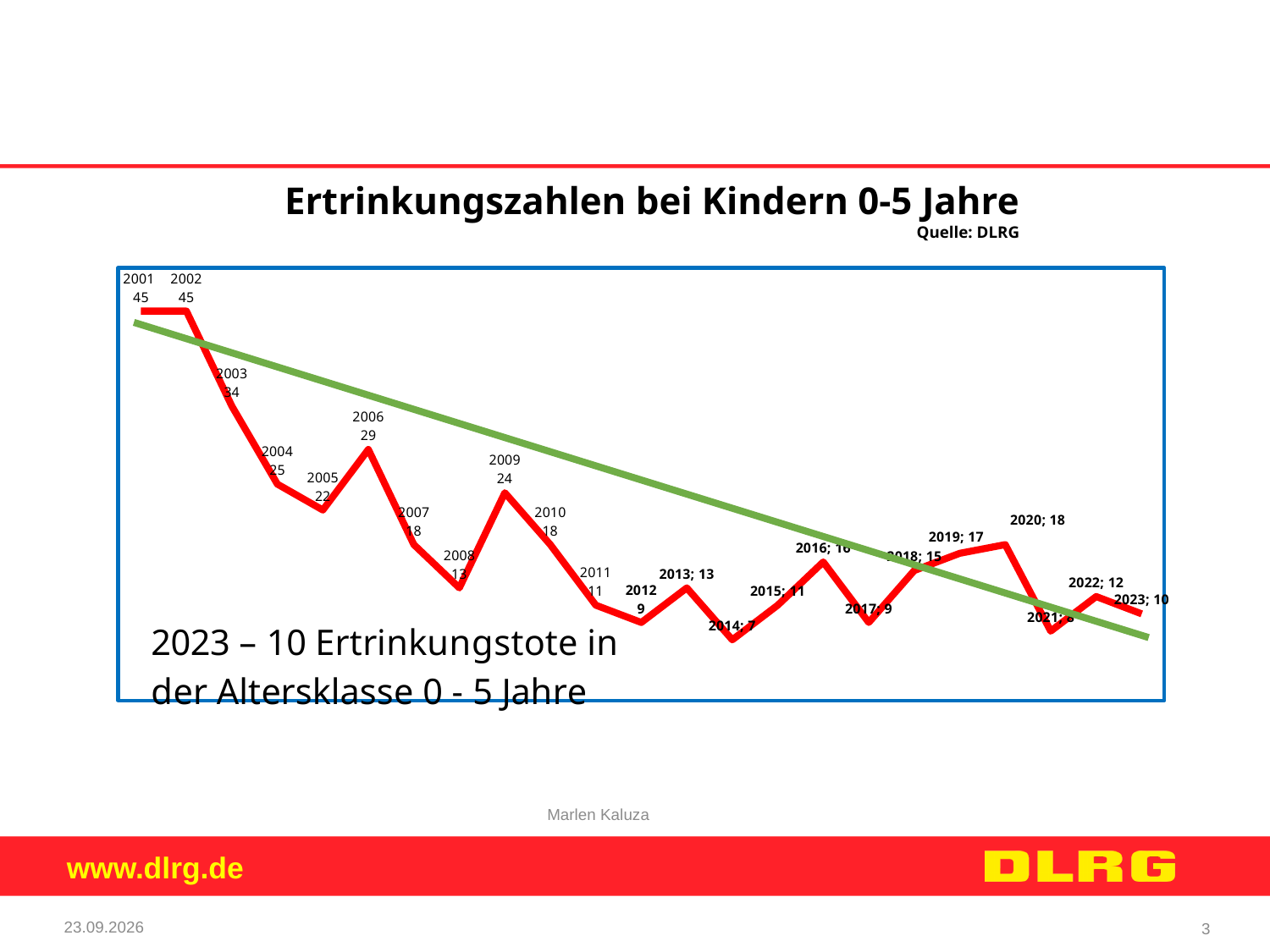
What is the difference between the values for 2003 and 2004? 9 What value is shown for 2020? 18 What value is shown for 2012? 9 What value is shown for 2023? 10 What value is shown for 2006? 29 Which year has the lowest value on the chart? 2014 Do the values generally rise or fall from 2001 to 2023? fall How many years are plotted on the chart? 23 What kind of chart is shown on the slide? line chart Which year has the larger value, 2009 or 2010? 2009 What is the difference between the values for 2001 and 2023? 35 What is the title of the chart? Ertrinkungszahlen bei Kindern 0-5 Jahre